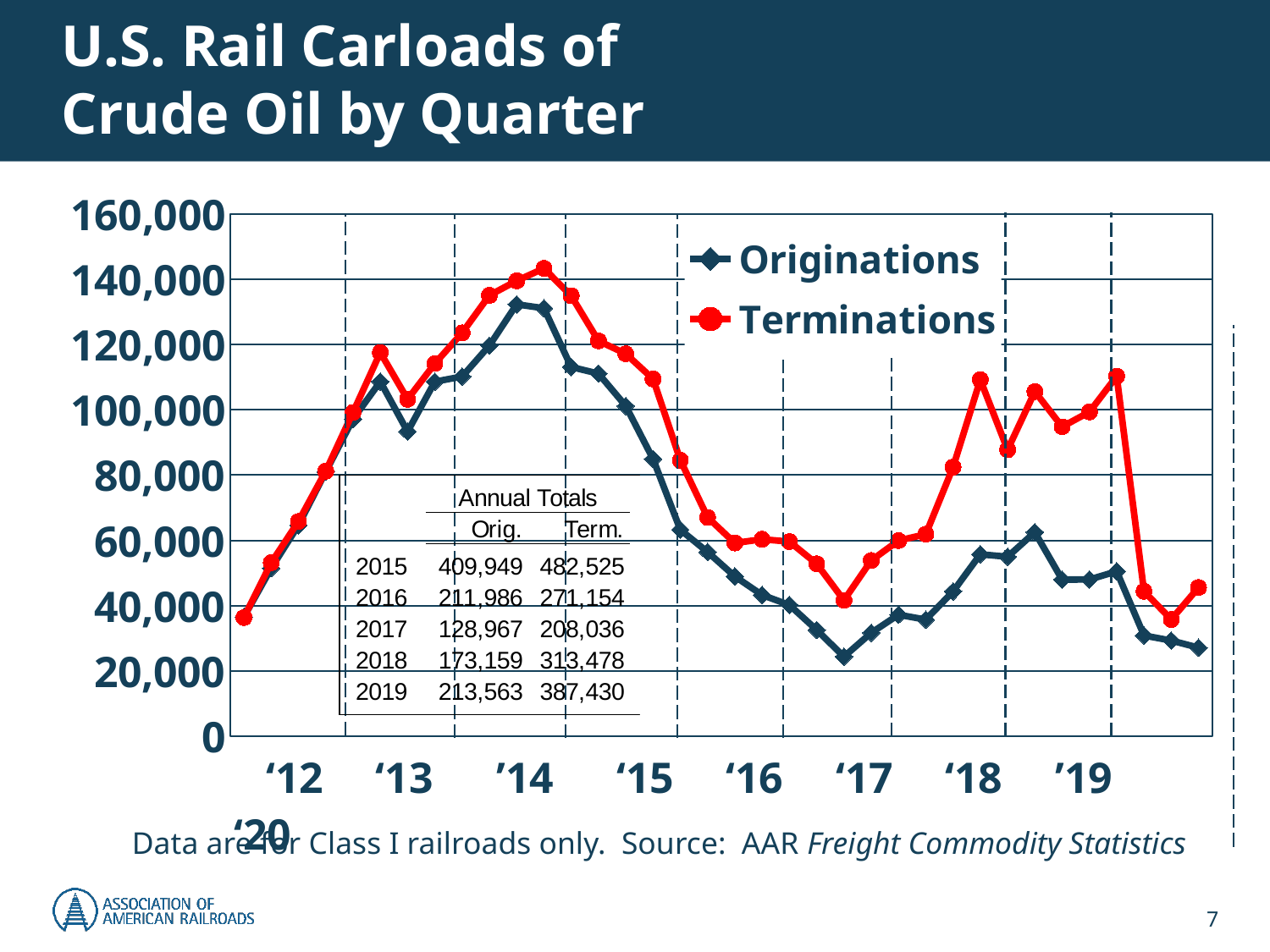
According to the Annual Totals table, what was the Originations total for 2015? 409,949 Is the lowest value of Originations in 2017 greater or less than 40,000? less According to the Annual Totals table, what was the Terminations total for 2019? 387,430 According to the Annual Totals table, which year had the lowest Originations total? 2017 Do the Originations values rise or fall from the 2014 peak through 2017? fall Is the peak value of Terminations in 2014 greater or less than 140,000? greater Do the Terminations values rise or fall from 2012 to the peak in 2014? rise Which series reaches the higher peak in 2014, Originations or Terminations? Terminations What kind of chart is shown on the slide? Line chart Is the peak value of Originations in 2014 greater or less than 120,000? greater Which series is drawn in red with circle markers? Terminations How many series does the legend list? 2